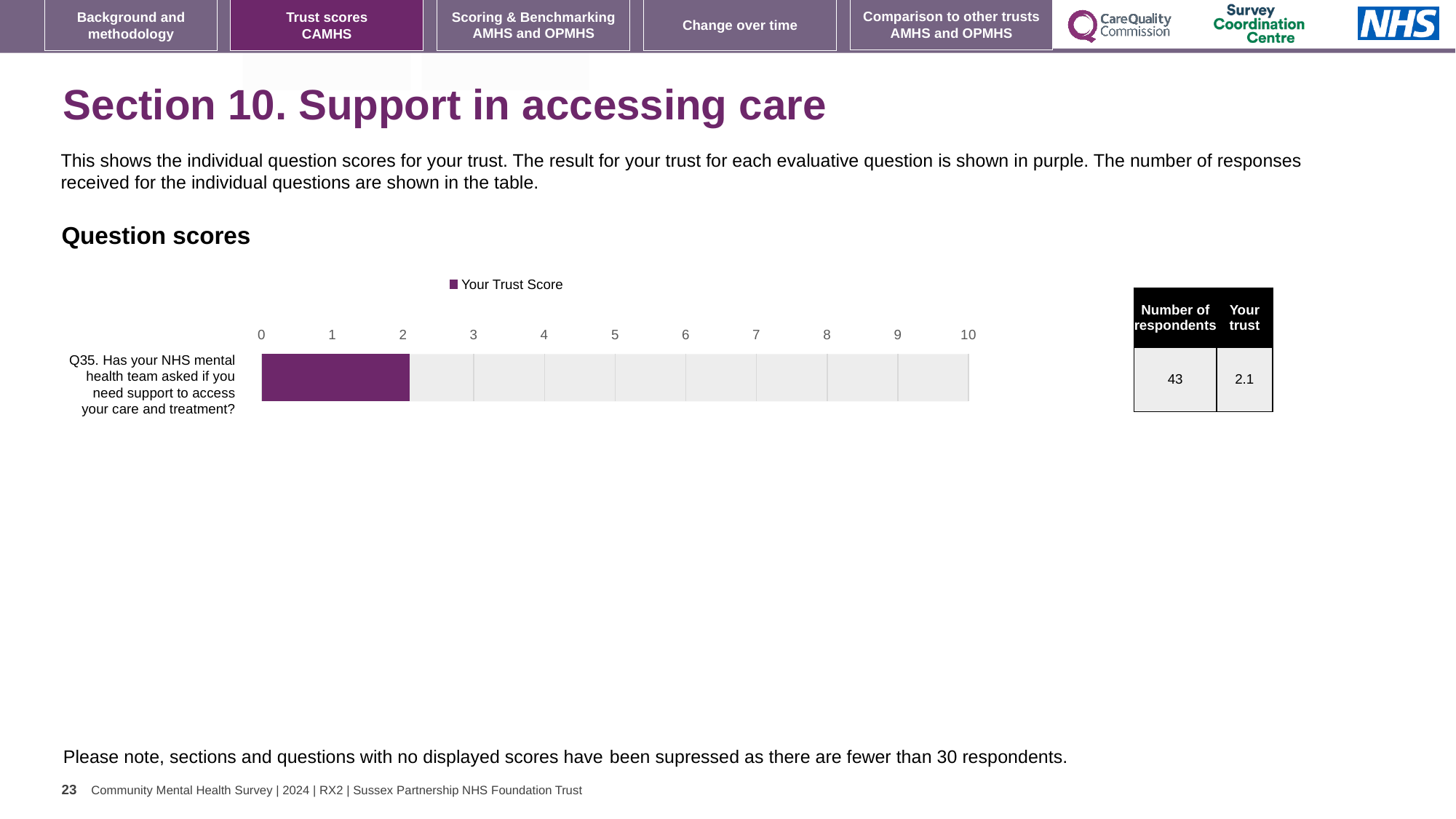
Is the value for Q35 greater or less than 3? less How many series does the legend of the chart list? 1 How many respondents answered Q35 according to the table? 43 Is the value for Q35 greater or less than 5? less What kind of chart is shown under 'Question scores'? bar chart How many questions (categories) are plotted in the chart? 1 What is the maximum value shown on the chart's horizontal axis? 10 What is the name of the series shown in the chart legend? Your Trust Score Is the value for Q35 greater or less than 1? greater What is the trust score for Q35 as shown in the table next to the chart? 2.1